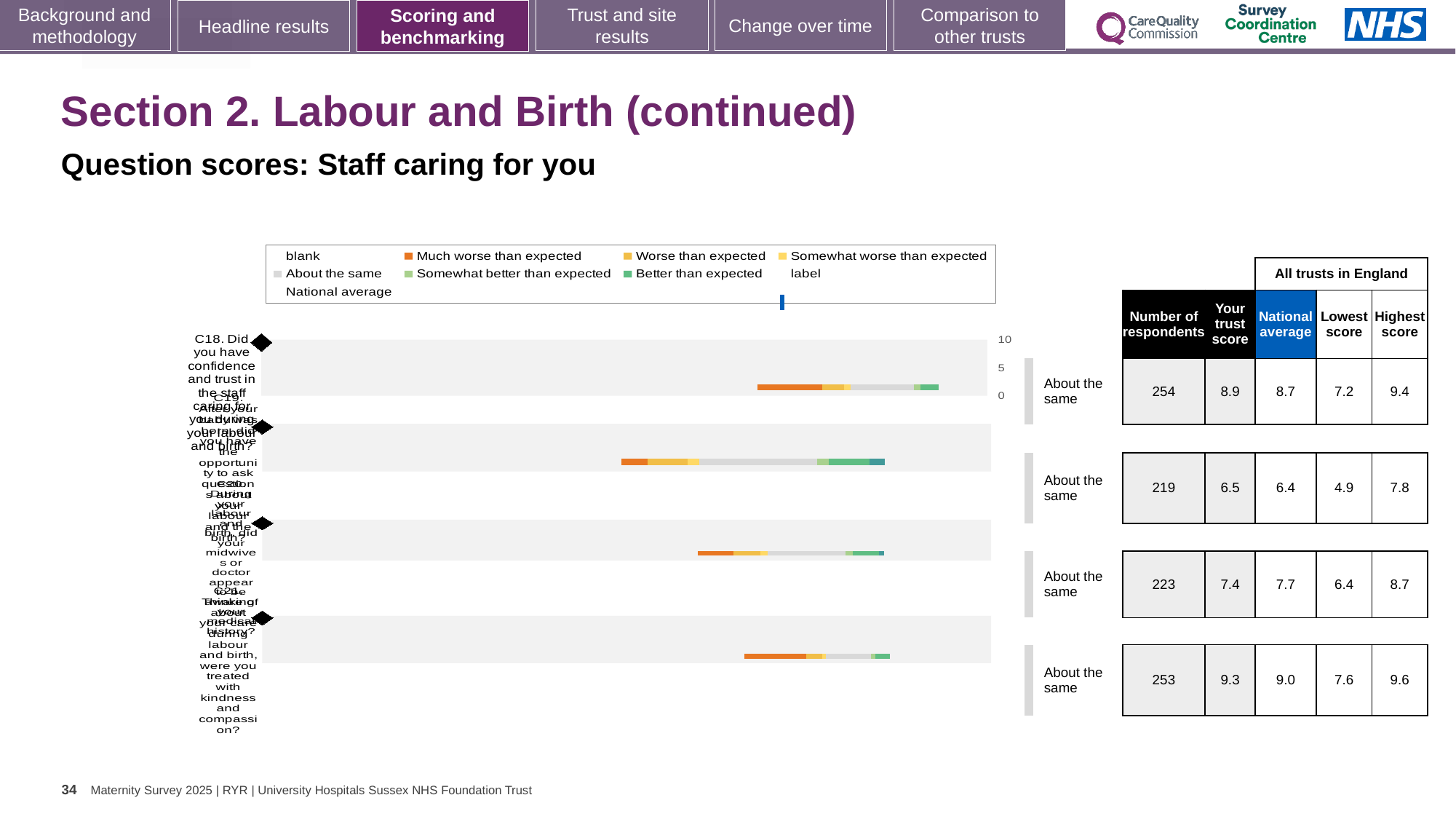
In the chart legend, what does the blue vertical marker represent? National average In the table beside the chart, for the third row, which is larger: 'Your trust score' or the national average? National average (7.7) In the table beside the chart, what is the number of respondents for the first row (C18)? 254 In the table beside the chart, what is the national average for the second row? 6.4 In the table beside the chart, what is 'Your trust score' for the first row (C18)? 8.9 How many question bars are plotted in the chart? 4 What kind of chart is shown on the slide? bar chart In the chart legend, what colour represents 'Much worse than expected'? orange In the table beside the chart, which row has the highest 'Your trust score'? the fourth row (C21), 9.3 In the table beside the chart, which row has the lowest 'Lowest score'? the second row, 4.9 What benchmark label is shown next to each of the four bars in the chart? About the same In the table beside the chart, what is the difference between the highest score and the lowest score for the first row (C18)? 2.2